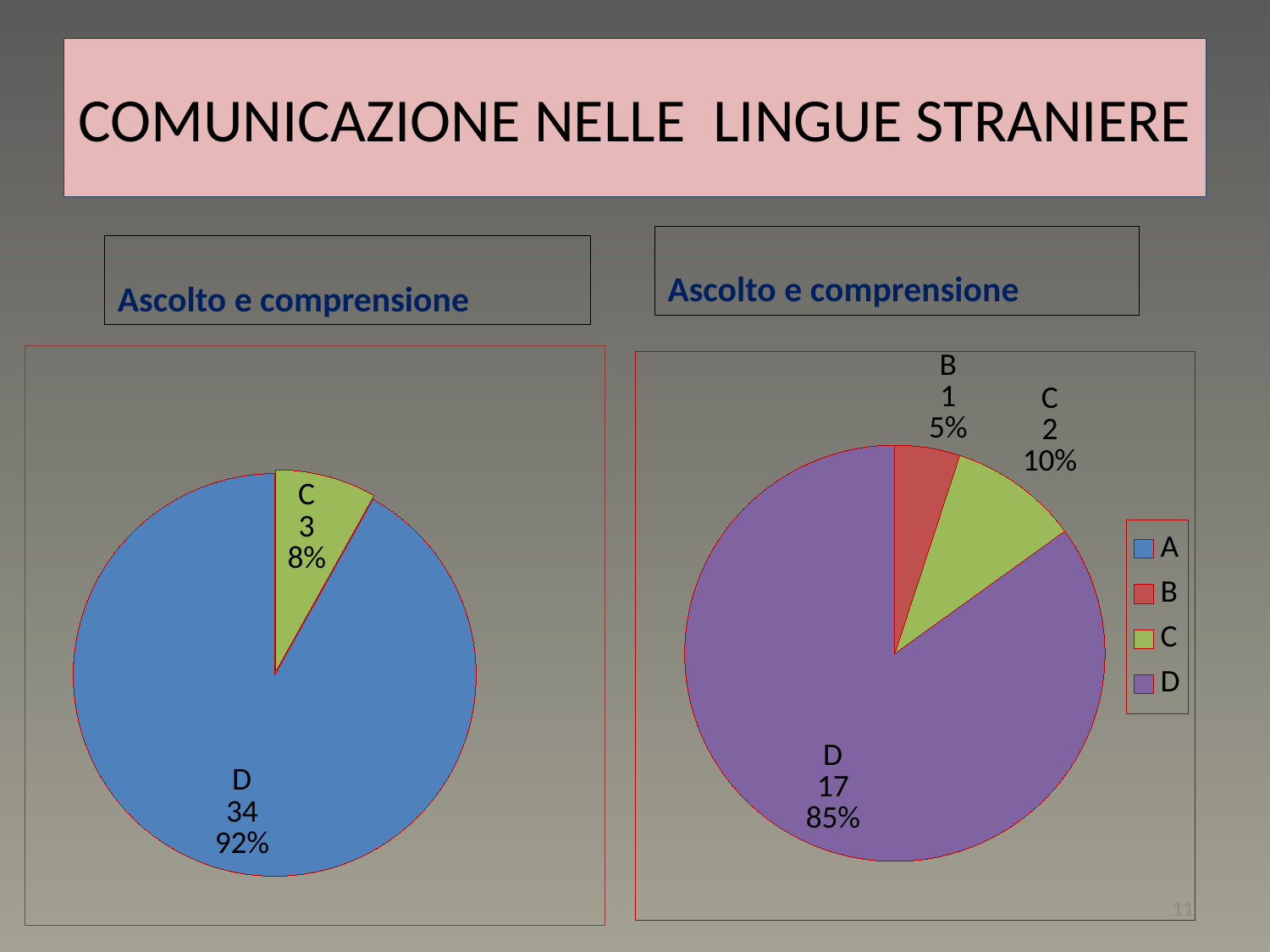
In the right pie chart, what is the difference between the values for D and C? 15 In the right pie chart, which is larger, the value for B or the value for C? C In the right pie chart, what share of the pie does D have? 85% In the left pie chart, what is the value for D? 34 In the left pie chart, what share of the pie does C have? 8% In the right pie chart, what is the value for C? 2 In the left pie chart, what is the difference between the values for D and C? 31 How many entries does the legend of the right pie chart list? 4 How many slices are shown in the left pie chart? 2 What kind of chart is the left chart on the slide? pie chart In the right pie chart, which category has the largest slice? D In the right pie chart, which category has the smallest slice? B